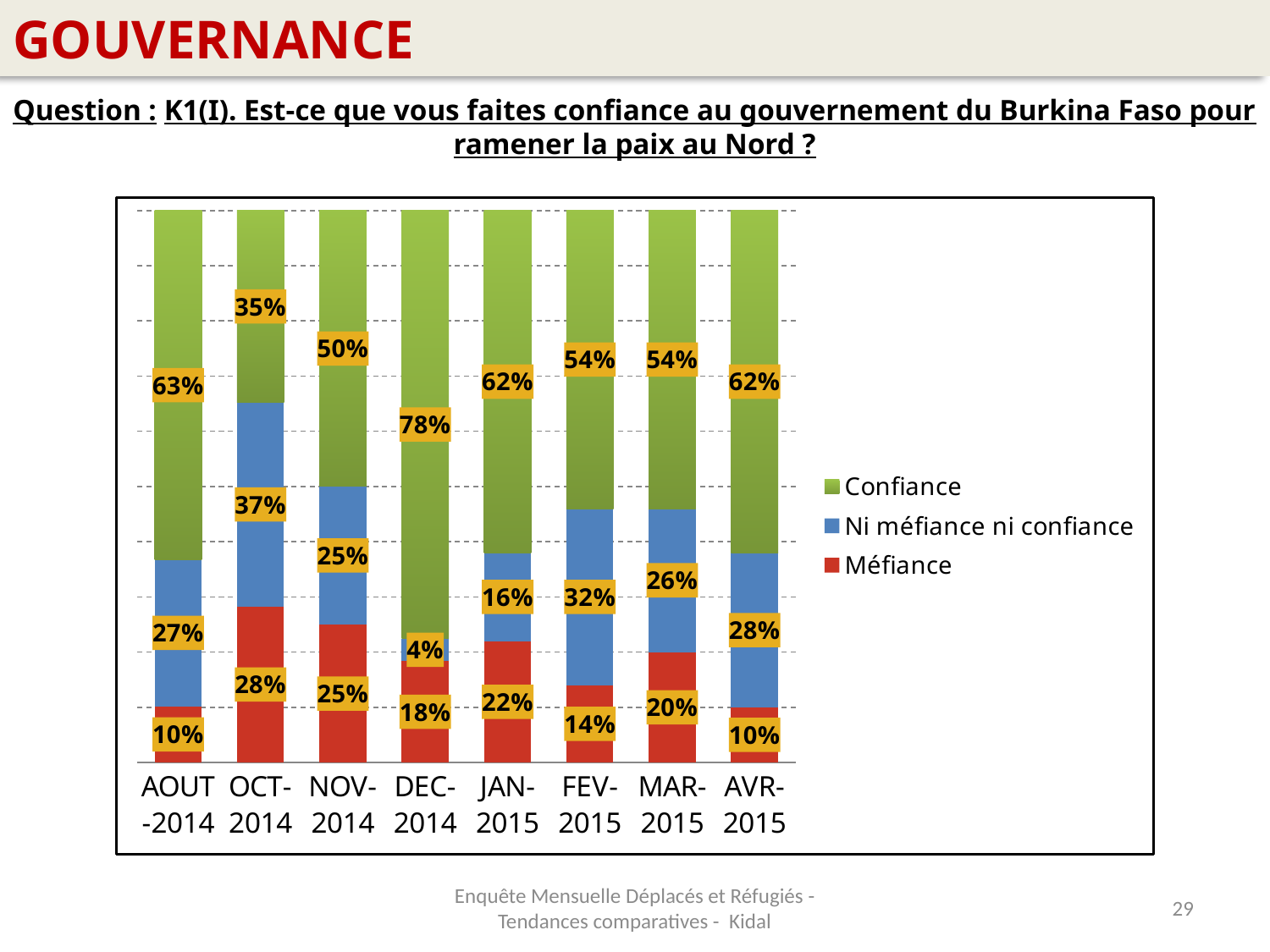
Which series is shown in green in the legend? Confiance How many series does the legend list? 3 In which month is the Ni méfiance ni confiance value the lowest? DEC-2014 What is the difference between the Confiance values in DEC-2014 and JAN-2015? 16% Which is larger, the Méfiance value in JAN-2015 or in MAR-2015? JAN-2015 What is the value for Méfiance in OCT-2014? 28% What is the value for Confiance in DEC-2014? 78% In which month is the Confiance value the highest? DEC-2014 What is the value for Ni méfiance ni confiance in FEV-2015? 32% How many months are shown on the x axis? 8 In which month is the Confiance value the lowest? OCT-2014 What kind of chart is shown on the slide? Stacked bar chart